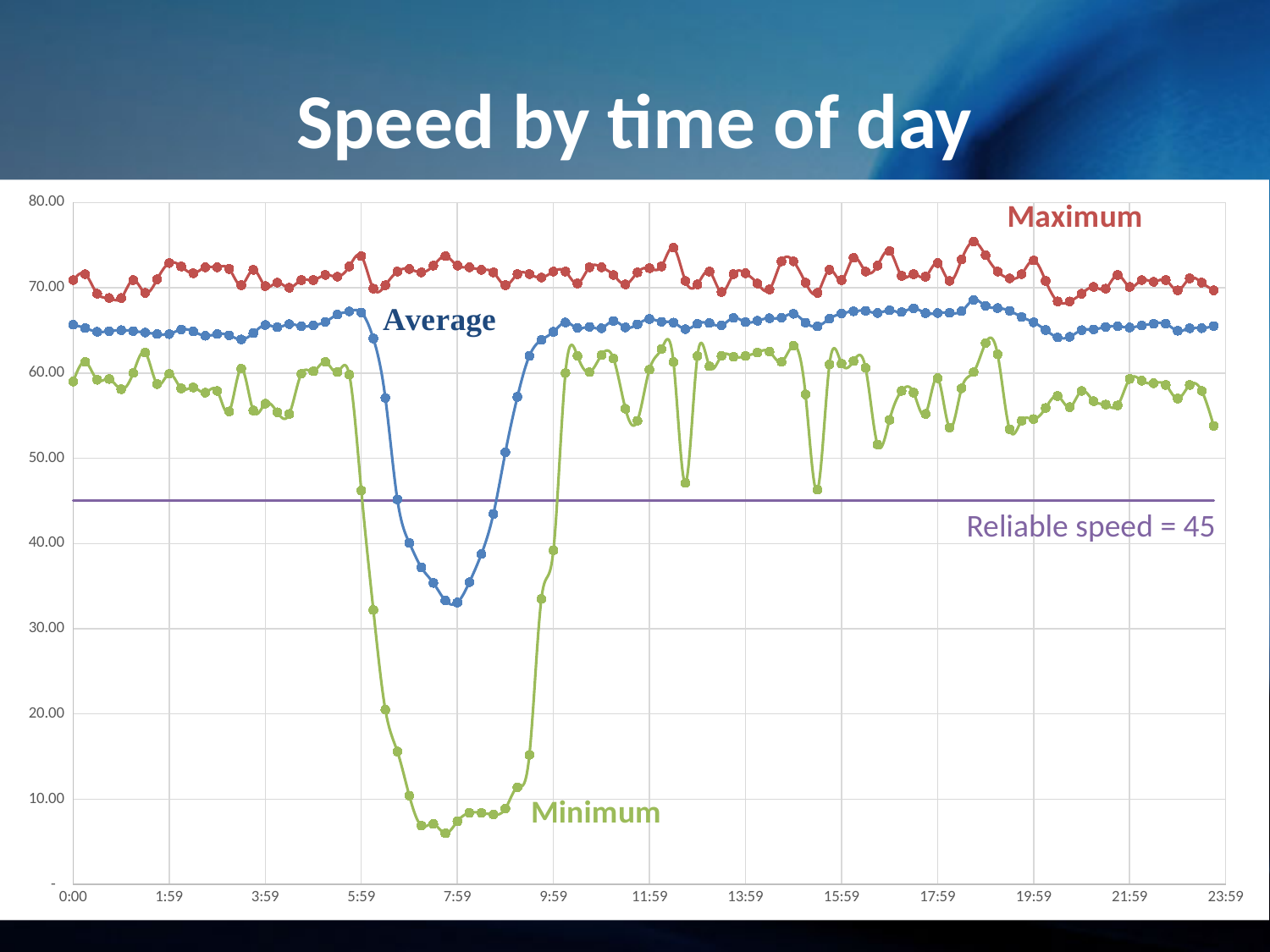
Is the Minimum value at 7:59 greater or less than 10? less How many speed series are labelled on the chart, excluding the reference line? 3 What kind of chart is shown on the slide? line chart At 7:59, which is larger, the Maximum value or the Minimum value? Maximum Is the Maximum value at 7:59 greater or less than 70? greater Which series is drawn in red? Maximum Does the Minimum series rise or fall between 7:59 and 9:59? rise What value does the horizontal reference line on the chart represent? Reliable speed = 45 Is the Average value at 7:59 greater or less than 40? less What is the title of the chart? Speed by time of day Does the Average series rise or fall between 5:59 and 7:59? fall